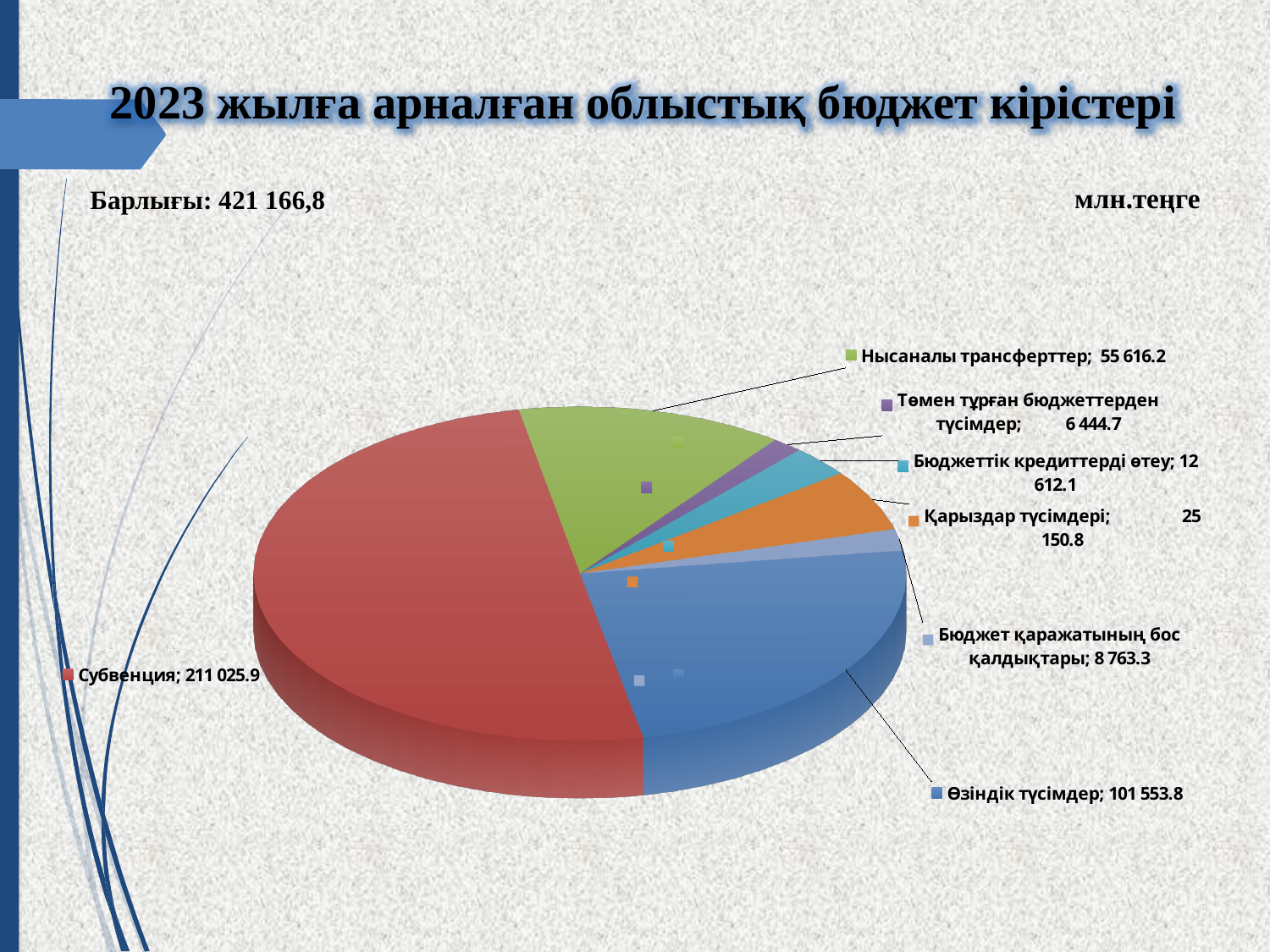
What is the value for Субвенция? 211 025.9 How many categories (slices) does the pie chart have? 7 Which is larger: Қарыздар түсімдері or Бюджеттік кредиттерді өтеу? Қарыздар түсімдері What is the value for Бюджет қаражатының бос қалдықтары? 8 763.3 What is the value for Өзіндік түсімдер? 101 553.8 Which category has the smallest slice of the pie? Төмен тұрған бюджеттерден түсімдер What is the total of all slices shown on the slide (Барлығы)? 421 166,8 What unit is stated for the values on the slide? млн.теңге Which category has the largest slice of the pie? Субвенция What is the value for Нысаналы трансферттер? 55 616.2 What is the difference between Субвенция and Өзіндік түсімдер? 109 472.1 What type of chart is shown on the slide? Pie chart